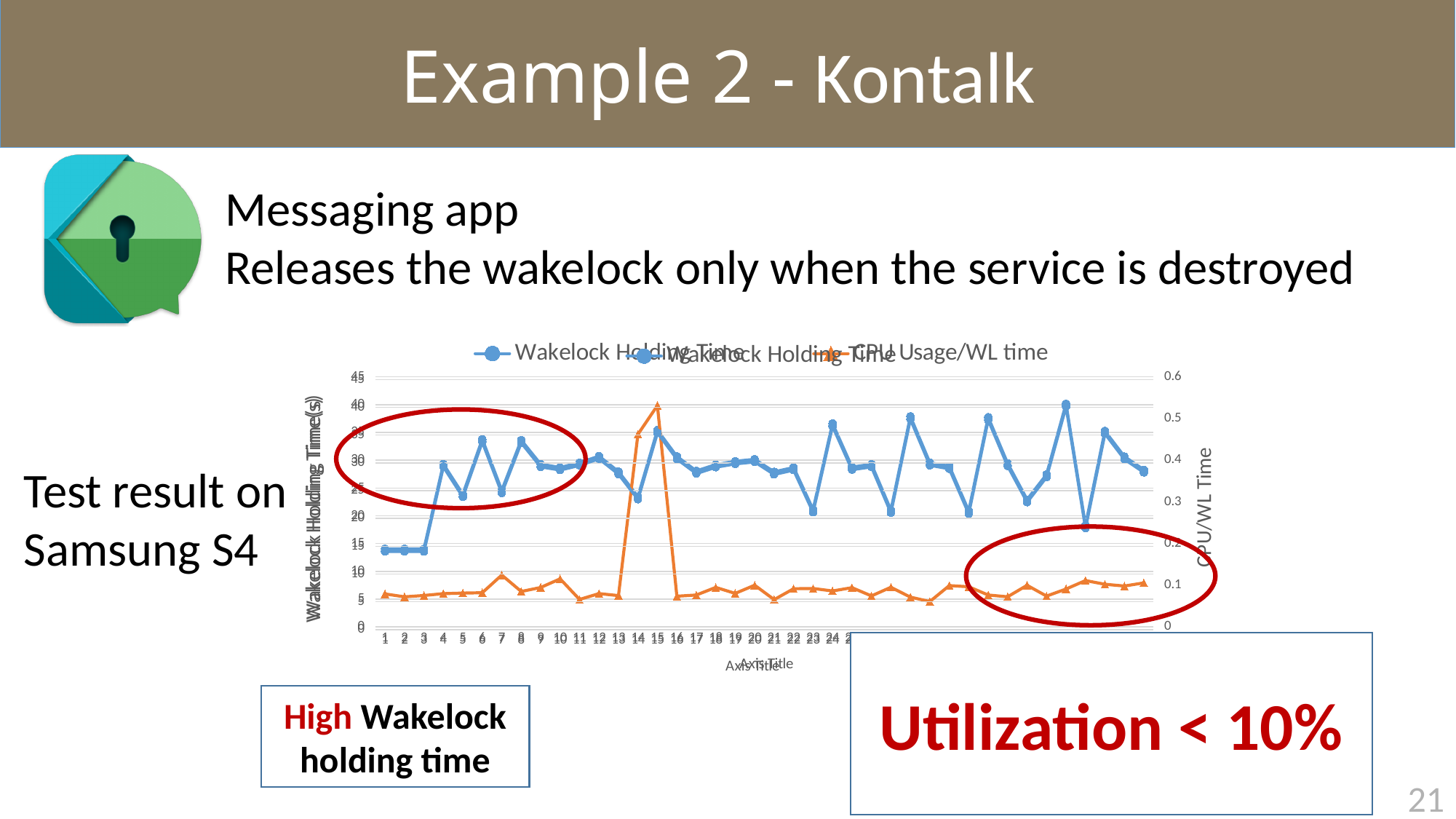
What kind of chart is shown on the slide? line chart At which x-axis point does CPU Usage/WL time reach its highest value? 15 Is the CPU Usage/WL time value at point 1 greater or less than 0.2? less Which is larger: the Wakelock Holding Time at point 1 or at point 15? point 15 Is the Wakelock Holding Time value at point 15 greater or less than 30? greater Is the Wakelock Holding Time value at point 4 greater or less than 25? greater Does the Wakelock Holding Time rise or fall from point 3 to point 4? rise Which is larger: the CPU Usage/WL time at point 15 or at point 16? point 15 What is the title of the left vertical axis? Wakelock Holding Time(s) Which series is drawn in orange? CPU Usage/WL time